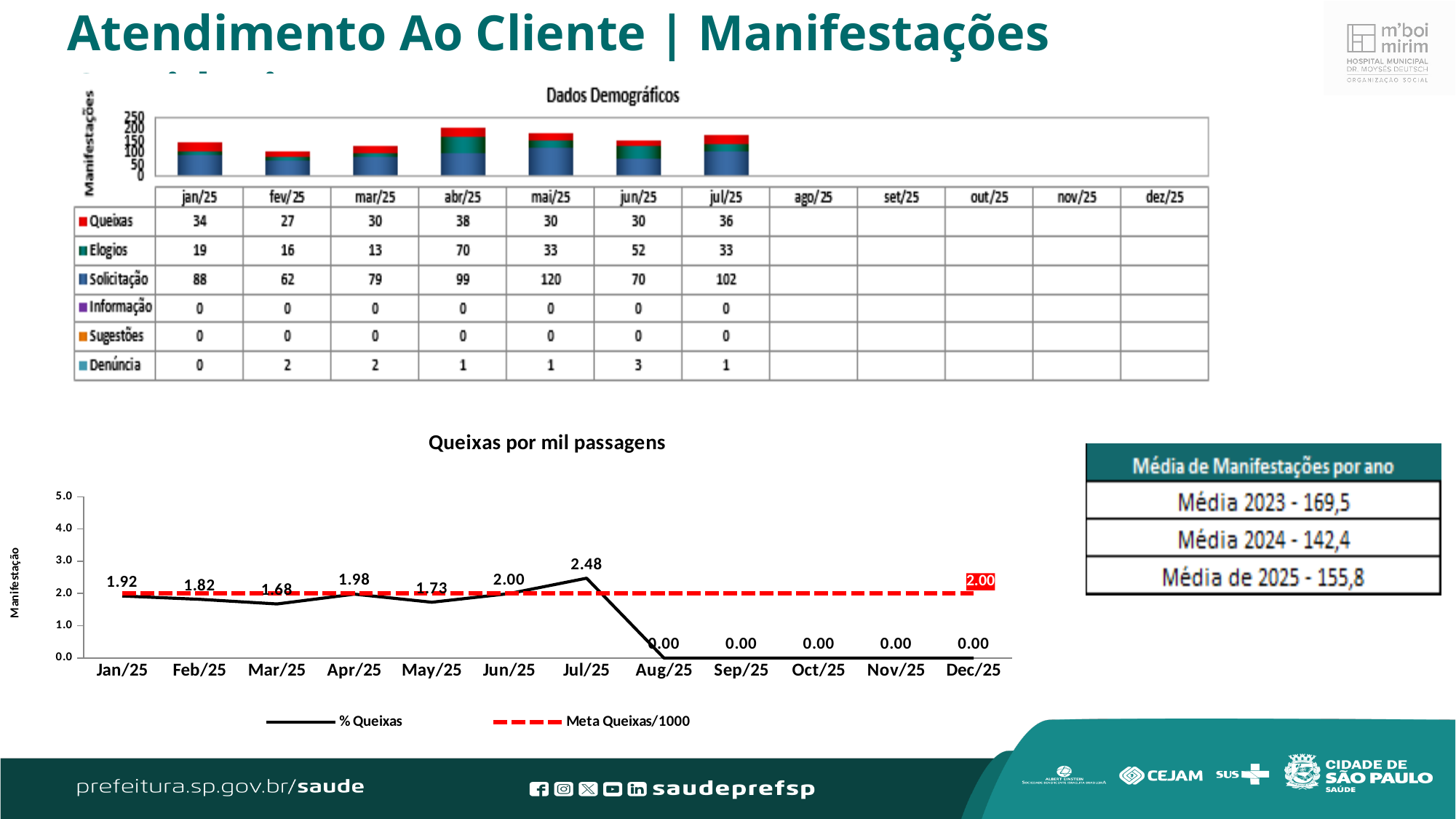
In the Queixas por mil passagens chart, which month has the highest % Queixas value? Jul/25 In the Queixas por mil passagens chart, what is the difference between the % Queixas values for Jul/25 and Jun/25? 0.48 In the Dados Demográficos chart, what is the value of Solicitação for mai/25? 120 In the Dados Demográficos chart, what is the value of Queixas for jan/25? 34 In the Dados Demográficos chart, which month has the lowest value for Solicitação? fev/25 In the Dados Demográficos chart, what is the total of the stacked bar for abr/25? 208 What kind of chart is Queixas por mil passagens? Line chart In the Dados Demográficos chart, how many series does the legend list? 6 In the Dados Demográficos chart, what is the difference between Solicitação in mai/25 and jun/25? 50 In the Dados Demográficos chart, is Queixas higher in abr/25 or fev/25? abr/25 In the Dados Demográficos chart, which month has the highest value for Elogios? abr/25 In the Queixas por mil passagens chart, what is the % Queixas value for Jul/25? 2.48